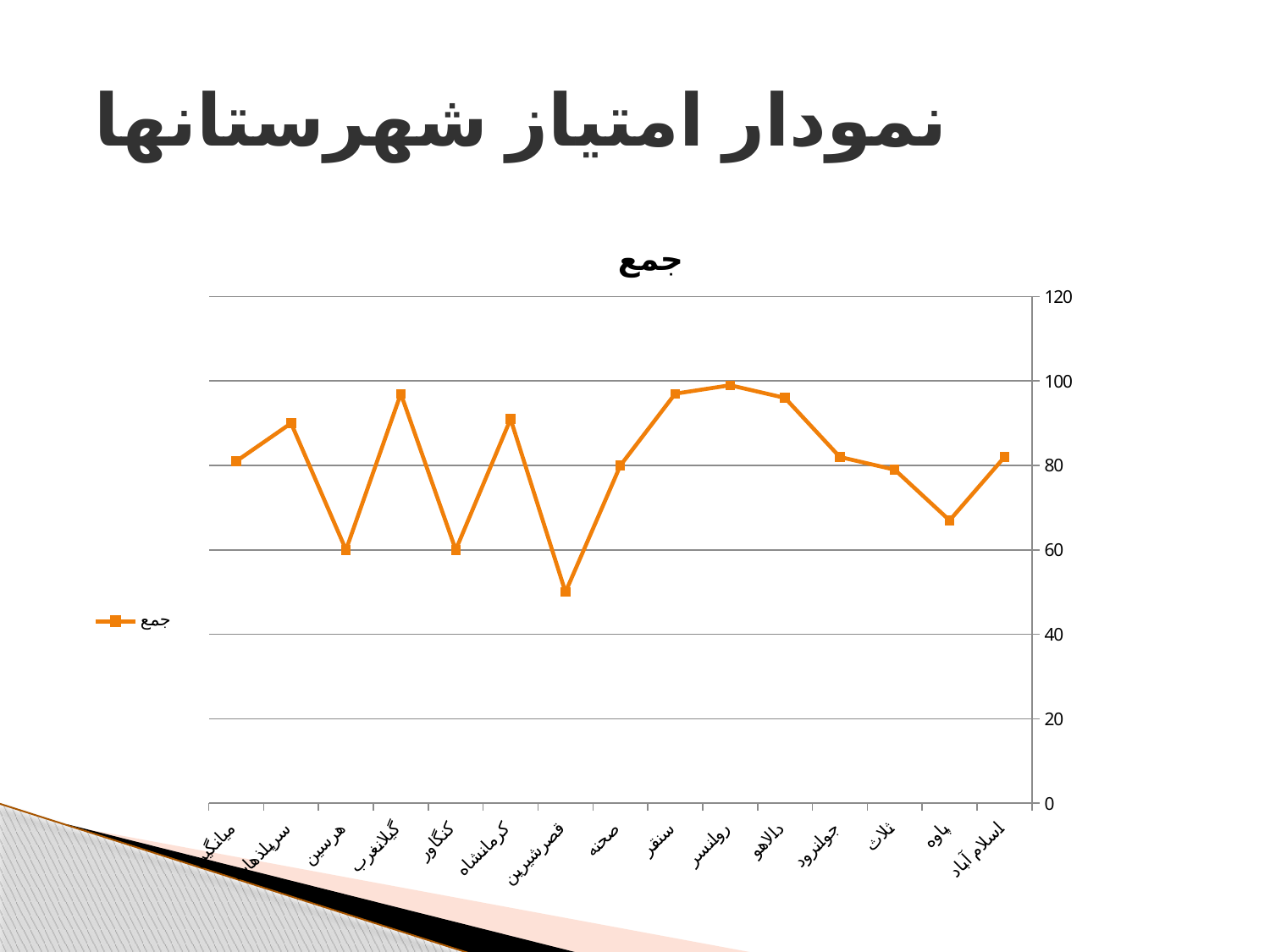
Which has the larger value, گیلانغرب or هرسین? گیلانغرب Is the value for گیلانغرب greater or less than 80? greater Is the value for پاوه greater or less than 80? less How many series does the legend list? 1 Is the value for قصرشیرین greater or less than 60? less What is the title of the chart? جمع How many categories are plotted along the x axis? 15 Which category has the lowest value? قصرشیرین What is the value for هرسین? 60 What kind of chart is shown on the slide? line chart Which has the larger value, پاوه or قصرشیرین? پاوه What is the value for کنگاور? 60